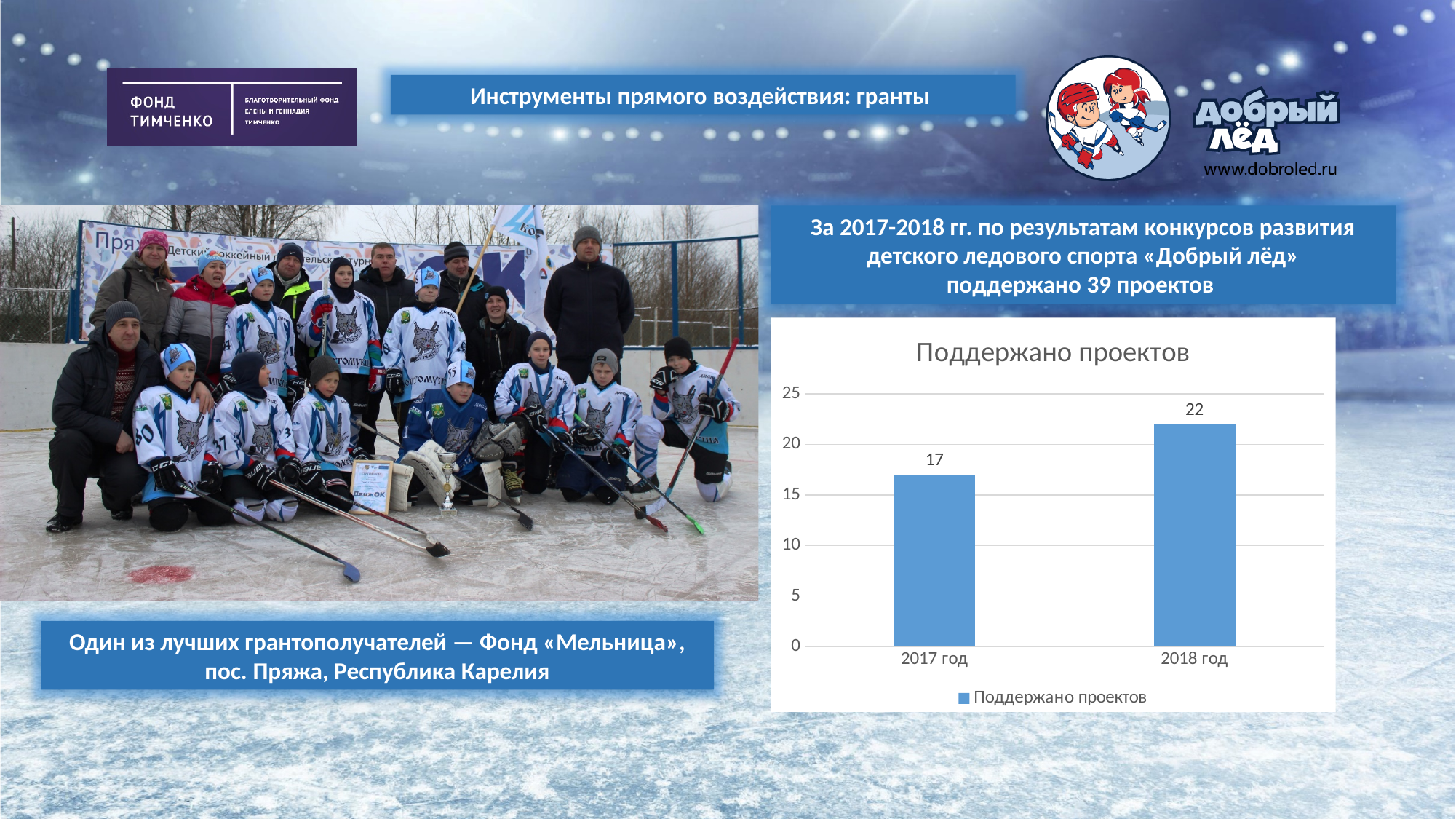
What kind of chart is shown on the slide? bar chart Which year has the highest number of supported projects? 2018 год How many series does the chart legend list? 1 Is the value for 2017 год greater or less than 20? less What is the difference between the values for 2018 год and 2017 год? 5 How many categories are shown on the x axis of the chart? 2 What is the value for 2018 год in the chart? 22 Which year has the lowest number of supported projects? 2017 год What is the value for 2017 год in the chart? 17 Which is larger, the value for 2017 год or 2018 год? 2018 год What is the title of the chart? Поддержано проектов Is the value for 2018 год greater or less than 20? greater